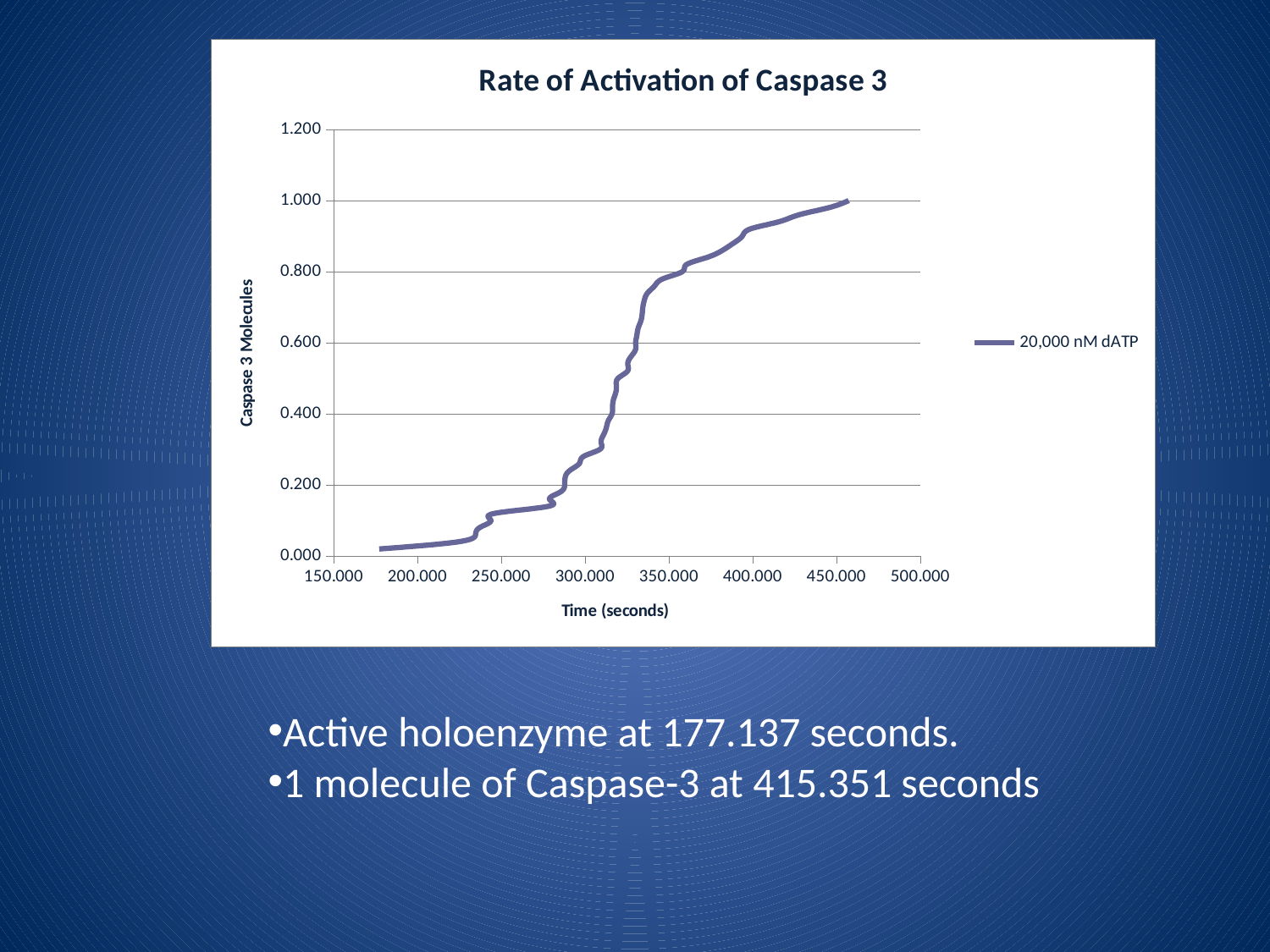
Is the value of the 20,000 nM dATP series at 400.000 seconds greater or less than 0.800? greater What series name is shown in the chart's legend? 20,000 nM dATP What is the title of the chart? Rate of Activation of Caspase 3 Do the values of the 20,000 nM dATP series rise or fall as time increases along the x axis? rise How many series does the chart's legend list? 1 Is the value of the 20,000 nM dATP series at 450.000 seconds greater or less than 0.800? greater Is the value of the 20,000 nM dATP series at 250.000 seconds greater or less than 0.200? less What kind of chart is shown on the slide? line chart Which is larger for the 20,000 nM dATP series: the value at 300.000 seconds or the value at 400.000 seconds? 400.000 seconds